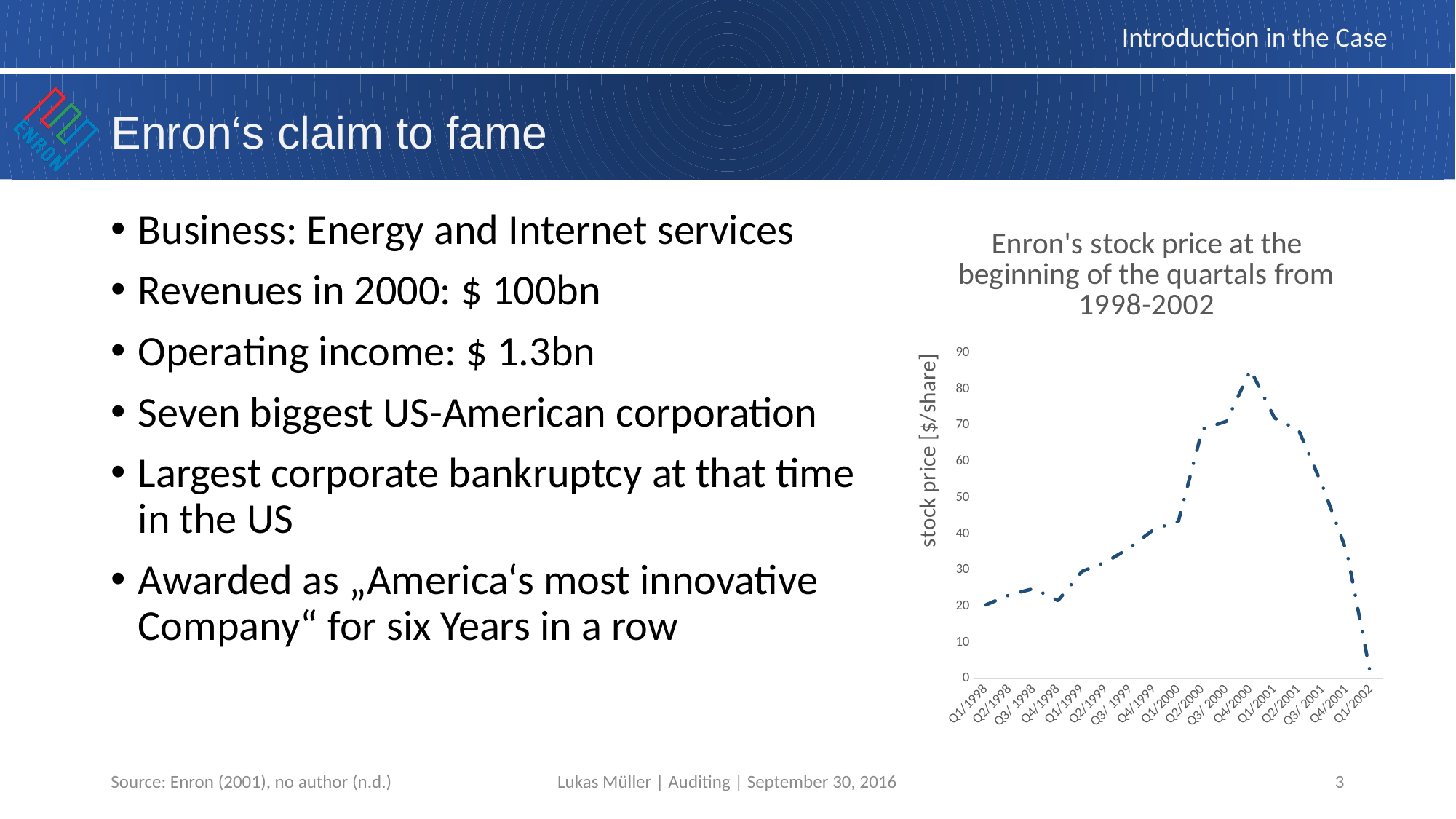
In which quarter does the stock price reach its highest value? Q4/2000 What is the title of the chart? Enron's stock price at the beginning of the quartals from 1998-2002 How many quarters are plotted on the x axis of the chart? 17 Is the stock price for Q3/1999 greater or less than 40? less Is the stock price for Q4/2000 greater or less than 80? greater Which quarter has a higher stock price, Q3/2000 or Q1/1998? Q3/2000 In which quarter is the stock price at its lowest? Q1/2002 Is the stock price for Q1/2002 greater or less than 10? less Does the stock price generally rise or fall from Q1/1998 to Q4/2000? rise Does the stock price rise or fall from Q4/2000 to Q1/2002? fall What is the label of the vertical axis of the chart? stock price [$/share] What kind of chart is shown on the slide? line chart